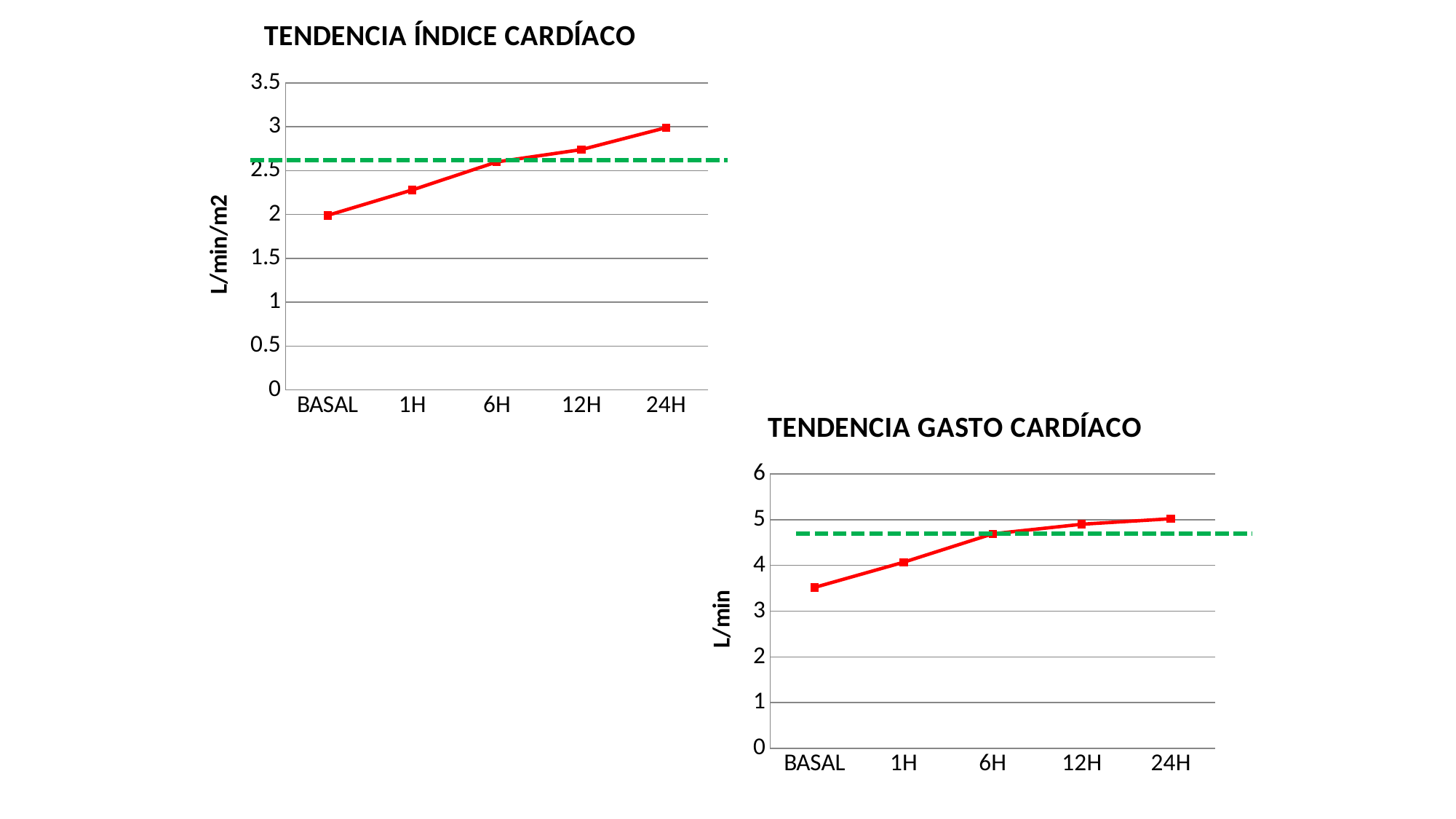
In the "TENDENCIA ÍNDICE CARDÍACO" chart, which time point has the highest value? 24H What is the y-axis label of the "TENDENCIA ÍNDICE CARDÍACO" chart? L/min/m2 In the "TENDENCIA ÍNDICE CARDÍACO" chart, is the value for BASAL greater or less than 2.5? less In the "TENDENCIA ÍNDICE CARDÍACO" chart, which time point has the lowest value? BASAL In the "TENDENCIA ÍNDICE CARDÍACO" chart, how many time points are plotted on the x axis? 5 In the "TENDENCIA GASTO CARDÍACO" chart, is the value for 6H greater or less than 4? greater In the "TENDENCIA GASTO CARDÍACO" chart, which is larger, the value for 1H or the value for 24H? 24H In the "TENDENCIA ÍNDICE CARDÍACO" chart, do the values rise or fall from BASAL to 24H? rise In the "TENDENCIA GASTO CARDÍACO" chart, which time point has the lowest value? BASAL In the "TENDENCIA ÍNDICE CARDÍACO" chart, is the value for 24H greater or less than 2.5? greater What kind of chart is the "TENDENCIA ÍNDICE CARDÍACO" chart? line chart